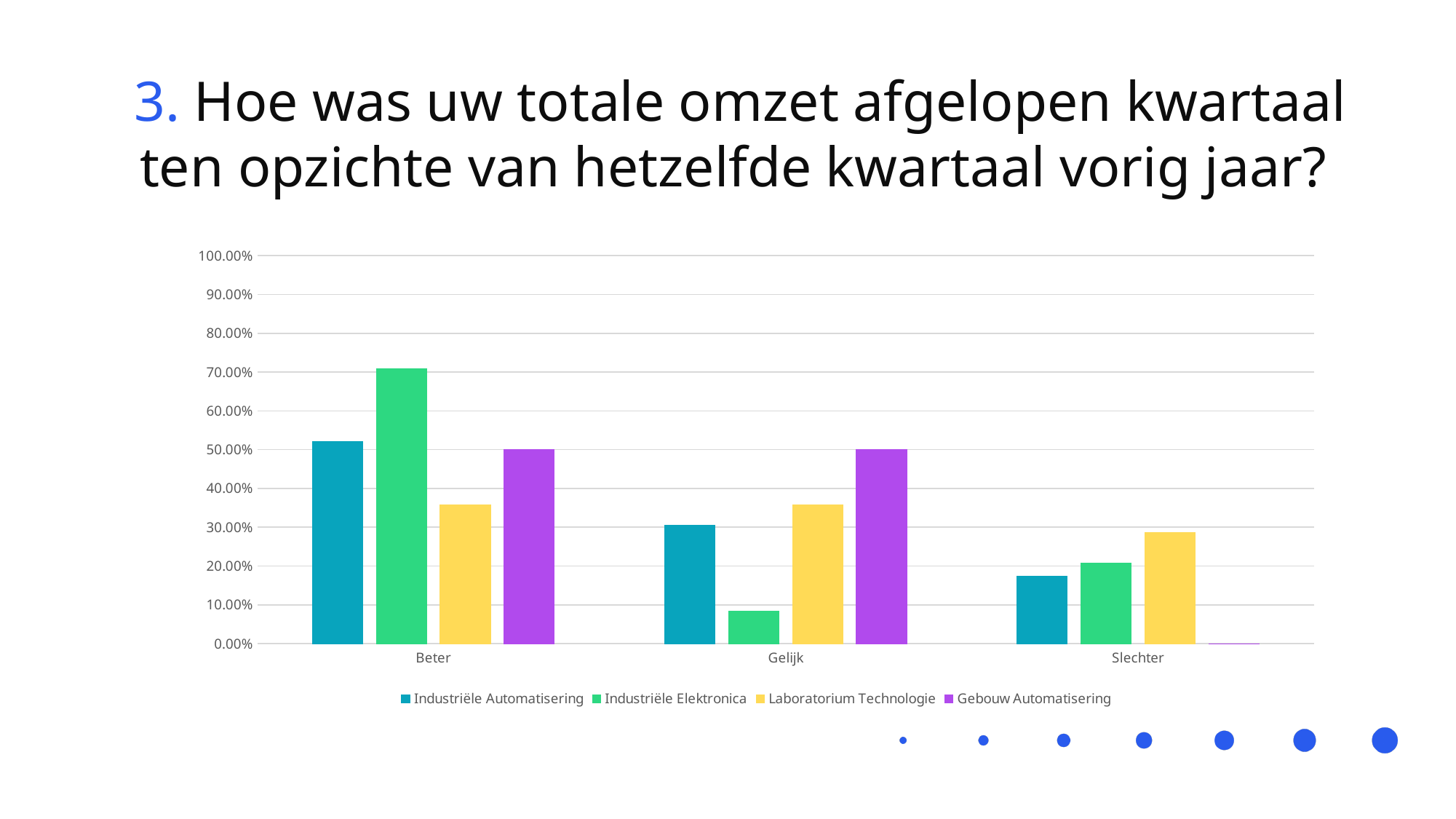
Is the value for Industriële Elektronica in the Gelijk category greater or less than 10.00%? less Is the value for Industriële Automatisering in the Slechter category greater or less than 20.00%? less In the Gelijk category, which is larger: Industriële Automatisering or Laboratorium Technologie? Laboratorium Technologie Which series has the highest value in the Beter category? Industriële Elektronica Which colour represents Gebouw Automatisering in the legend? purple Which series has the highest value in the Slechter category? Laboratorium Technologie Which series has the lowest value in the Gelijk category? Industriële Elektronica What kind of chart is shown on the slide? bar chart Is the value for Industriële Elektronica in the Beter category greater or less than 60.00%? greater How many categories are shown on the x axis? 3 Which series has the lowest value in the Slechter category? Gebouw Automatisering How many series does the legend list? 4